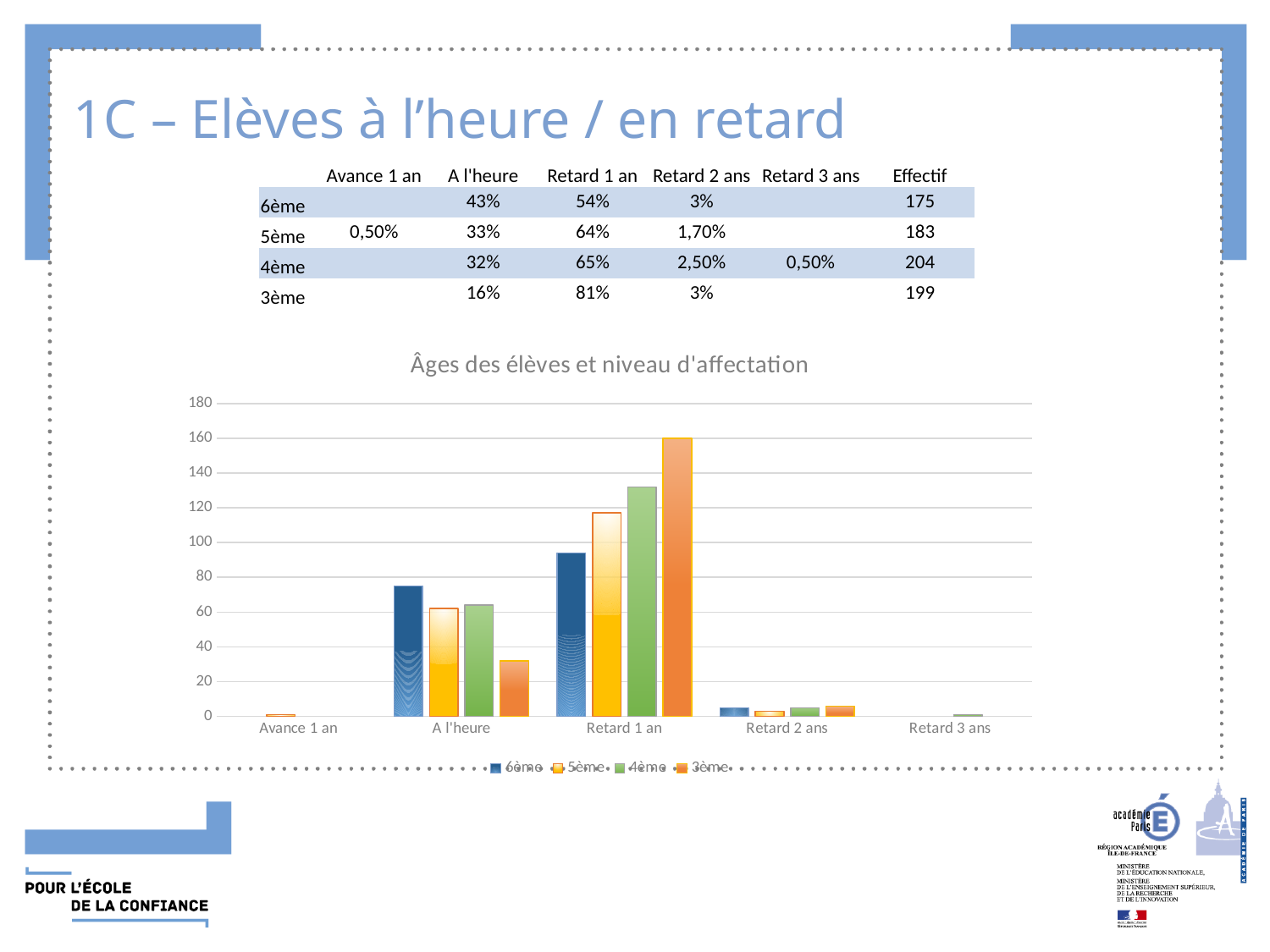
Which series has the shortest bar in the 'A l'heure' category? 3ème How many series does the chart legend list? 4 Which series has the tallest bar in the 'A l'heure' category? 6ème What kind of chart is shown on the slide? bar chart Is the value for 5ème in the 'Retard 1 an' category greater or less than 100? greater For the 3ème series, does the value rise or fall from 'A l'heure' to 'Retard 1 an'? rise Is the value for 3ème in the 'A l'heure' category greater or less than 40? less What is the title of the chart? Âges des élèves et niveau d'affectation Is the value for 4ème in the 'Retard 1 an' category greater or less than 120? greater How many categories are shown along the x axis of the chart? 5 In the 'A l'heure' category, which bar is taller: 6ème or 5ème? 6ème Which series has the tallest bar in the 'Retard 1 an' category? 3ème